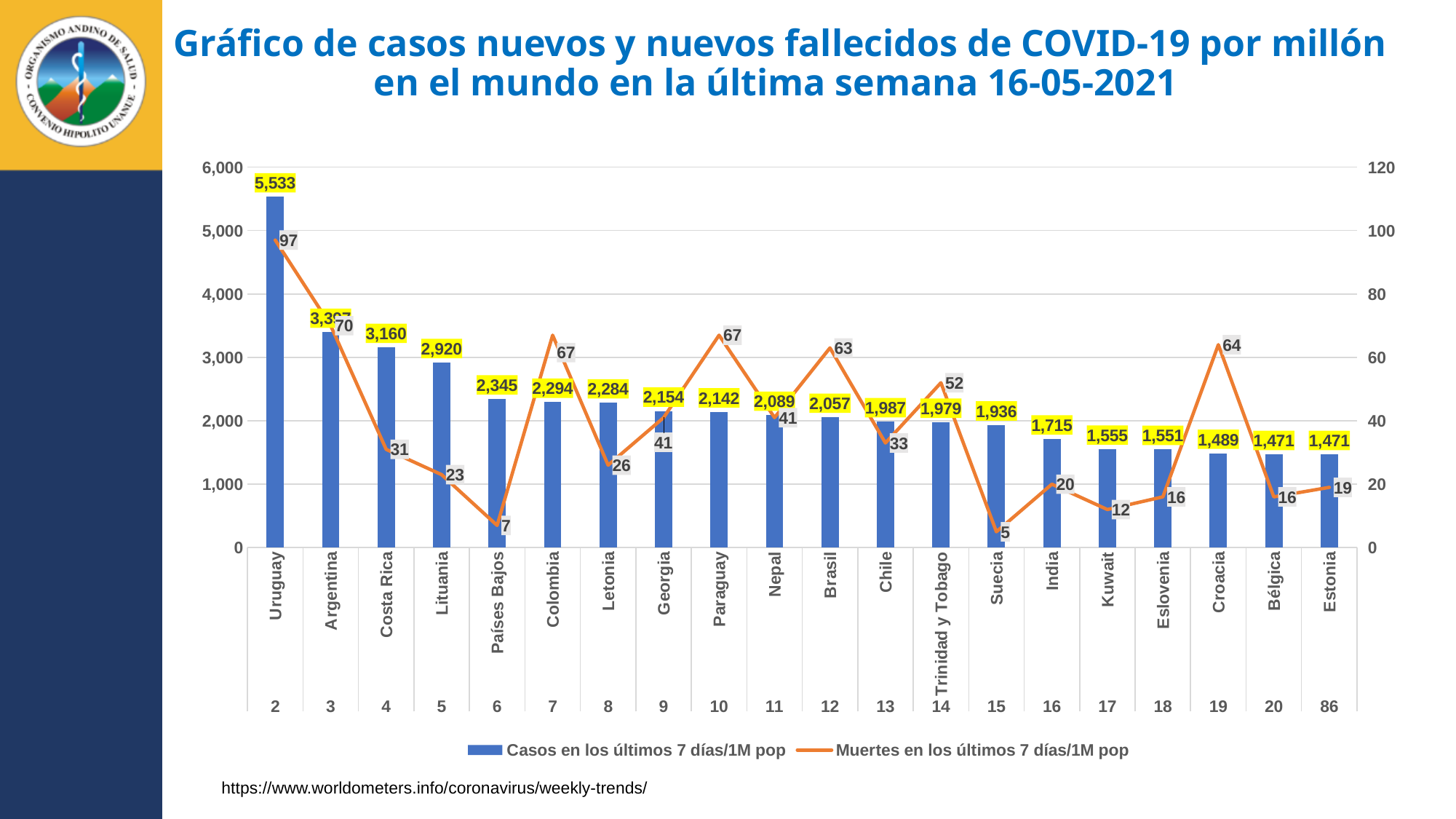
Which country has the highest value of 'Casos en los últimos 7 días/1M pop'? Uruguay What kind of chart is used to show 'Casos en los últimos 7 días/1M pop'? Bar chart What is the difference between the 'Casos en los últimos 7 días/1M pop' values for Uruguay and Costa Rica? 2,373 Is the value of 'Casos en los últimos 7 días/1M pop' for Lituania greater or less than 2,000? greater Which has a higher value of 'Muertes en los últimos 7 días/1M pop', Brasil or Chile? Brasil What is the value of 'Casos en los últimos 7 días/1M pop' for Uruguay? 5,533 Which country has the lowest value of 'Muertes en los últimos 7 días/1M pop'? Suecia How many countries are shown on the x axis of the chart? 20 What is the value of 'Casos en los últimos 7 días/1M pop' for Costa Rica? 3,160 What is the value of 'Muertes en los últimos 7 días/1M pop' for Colombia? 67 Do the 'Casos en los últimos 7 días/1M pop' values rise or fall from Uruguay to Estonia along the x axis? Fall How many series does the legend list? 2